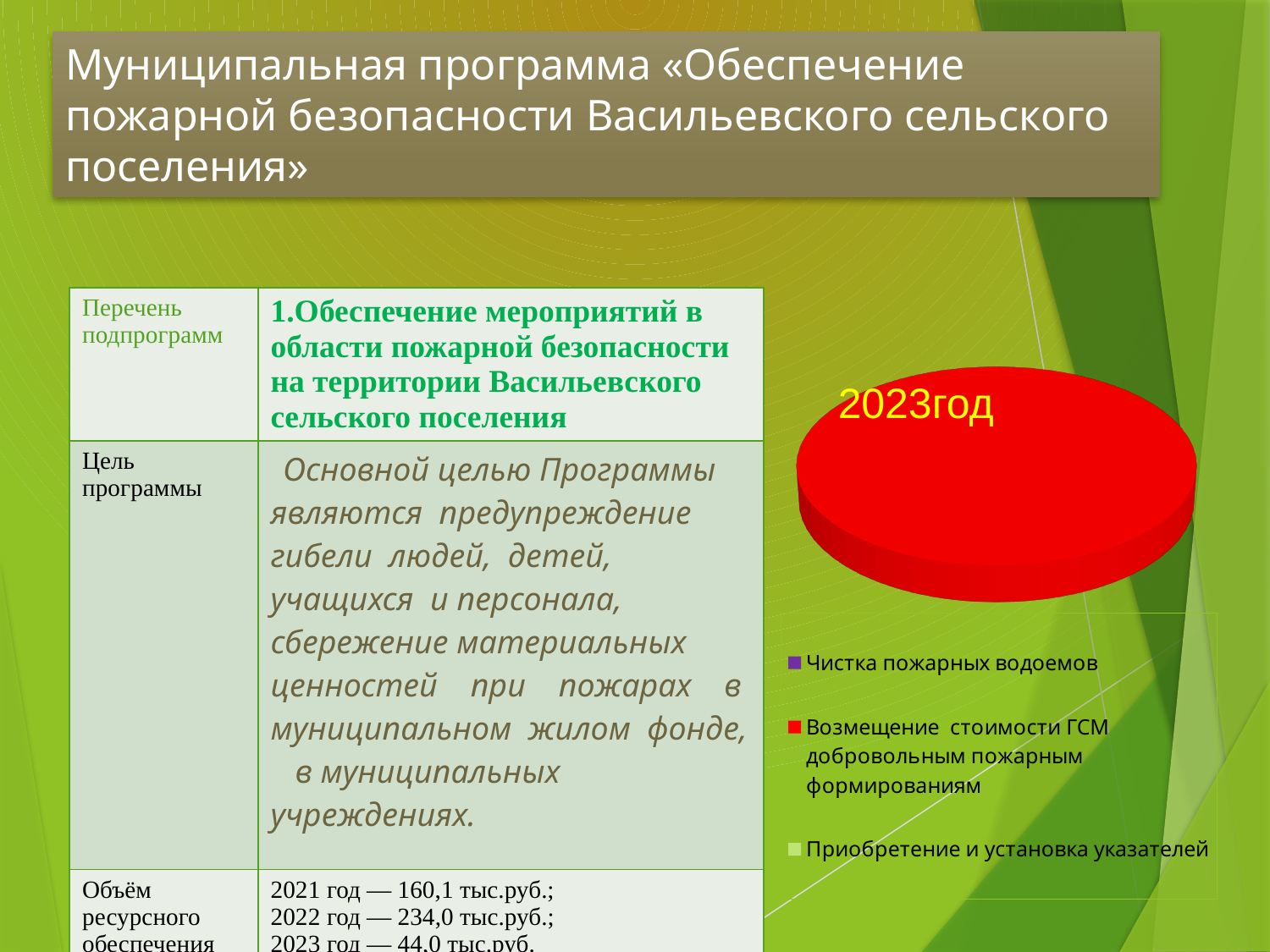
Which category takes up the largest share of the pie chart? Возмещение стоимости ГСМ добровольным пожарным формированиям What colour represents "Возмещение стоимости ГСМ добровольным пожарным формированиям" in the pie chart legend? red Which legend entry of the pie chart is listed first? Чистка пожарных водоемов How many entries does the legend of the pie chart list? 3 What is the title of the pie chart? 2023год What kind of chart is shown on the right side of the slide? pie chart